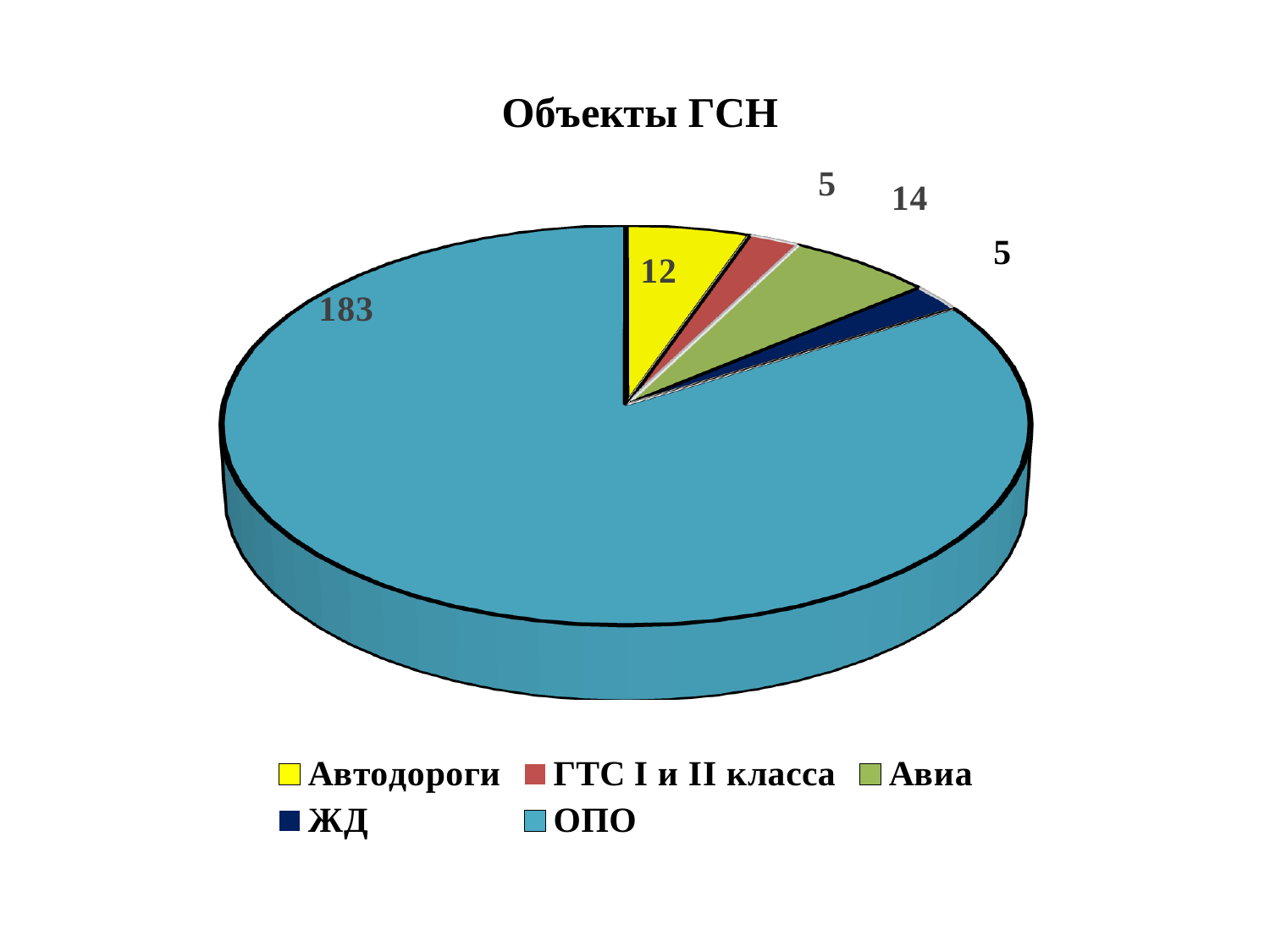
What colour is the slice for ОПО? teal (light blue) Which category has the largest slice? ОПО What is the value for ЖД? 5 How many categories does the legend list? 5 What is the value for Автодороги? 12 What kind of chart is shown on the slide? pie chart What is the title of the pie chart? Объекты ГСН What is the value for ОПО? 183 What is the value for ГТС I и II класса? 5 Which is larger, the value for Авиа or the value for Автодороги? Авиа What is the difference between the values for ОПО and Авиа? 169 What is the value for Авиа? 14